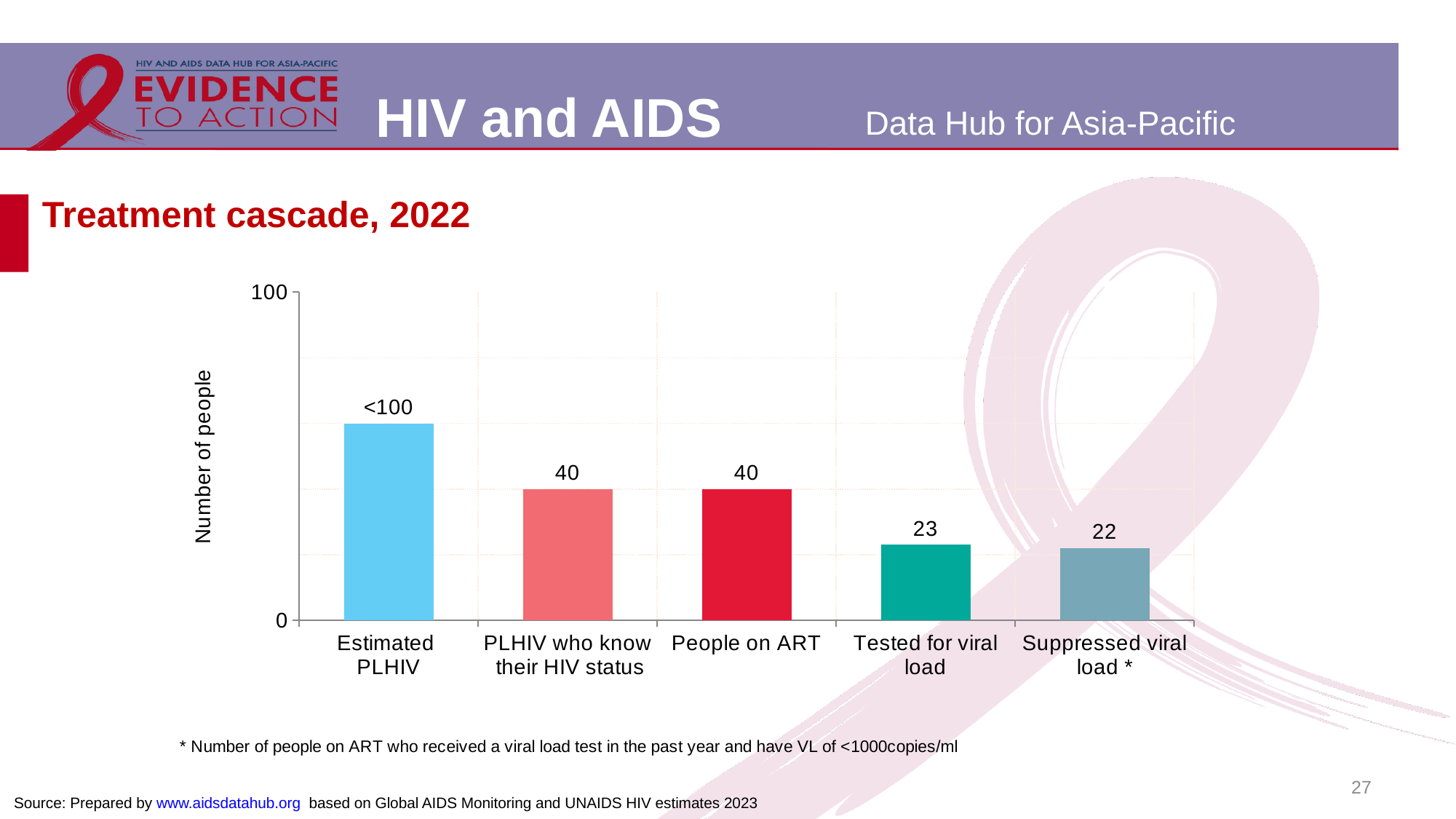
What is the label of the y axis? Number of people How many categories are shown in the chart? 5 What is the data label shown for Estimated PLHIV? <100 What is the value for Tested for viral load? 23 What type of chart is shown on the slide? bar chart What is the difference between the values for People on ART and Tested for viral load? 17 What is the title of the chart? Treatment cascade, 2022 What is the value for PLHIV who know their HIV status? 40 Which category has the highest bar? Estimated PLHIV Which is larger, the value for PLHIV who know their HIV status or the value for Suppressed viral load? PLHIV who know their HIV status What is the value for Suppressed viral load? 22 What is the value for People on ART? 40